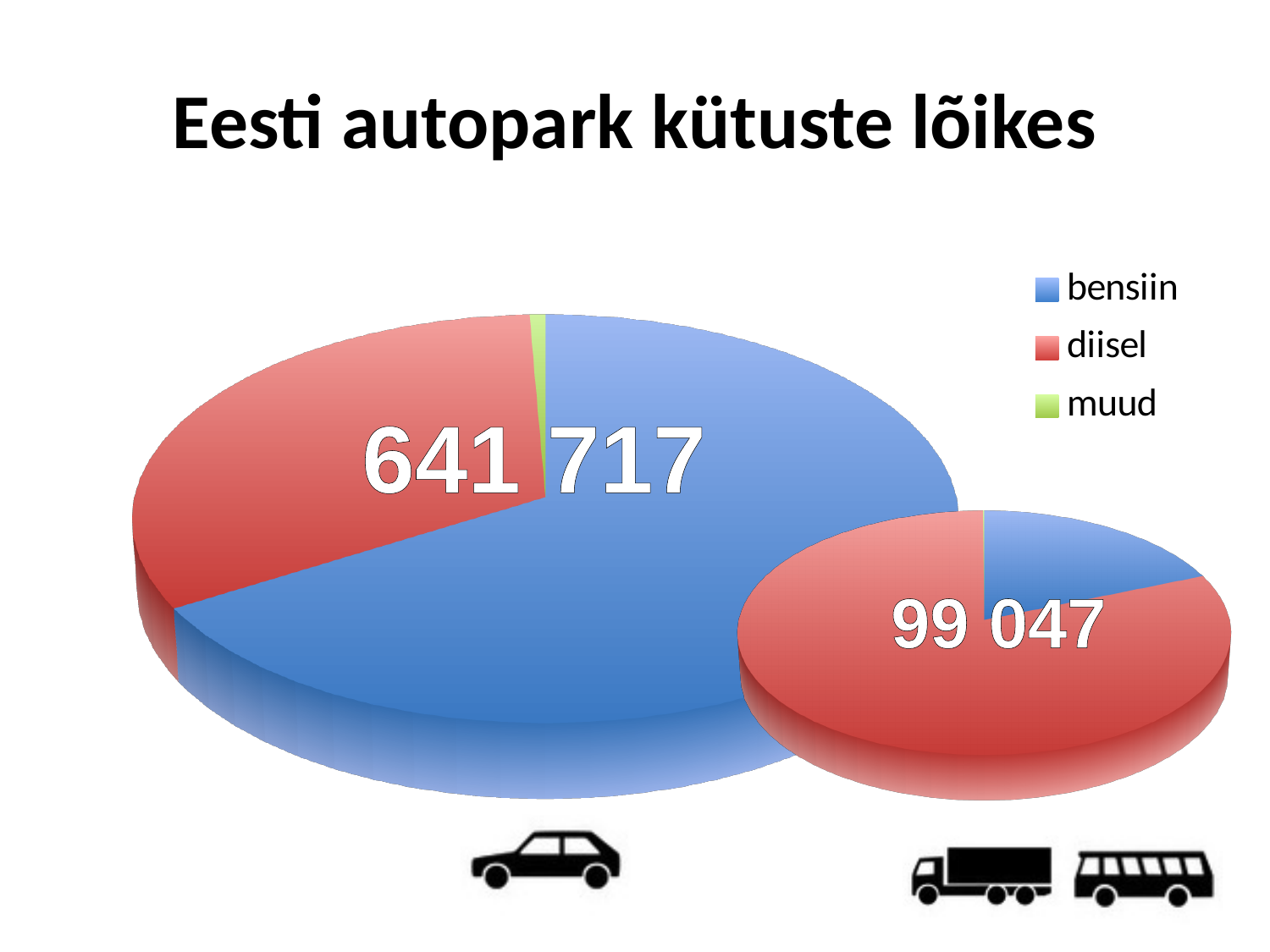
In the larger pie chart on the left, which category has the smallest slice? muud In the larger pie chart on the left, which slice is bigger, bensiin or diisel? bensiin In the smaller pie chart on the right, which slice is bigger, bensiin or diisel? diisel What kind of chart is the smaller chart on the right of the slide? pie chart What is the title of the slide? Eesti autopark kütuste lõikes What number is printed on the larger pie chart on the left? 641 717 In the larger pie chart on the left, which category has the largest slice? bensiin How many entries does the legend list? 3 What kind of chart is the larger chart on the left of the slide? pie chart What number is printed on the smaller pie chart on the right? 99 047 How many slices are visible in the larger pie chart on the left? 3 In the smaller pie chart on the right, which category has the largest slice? diisel